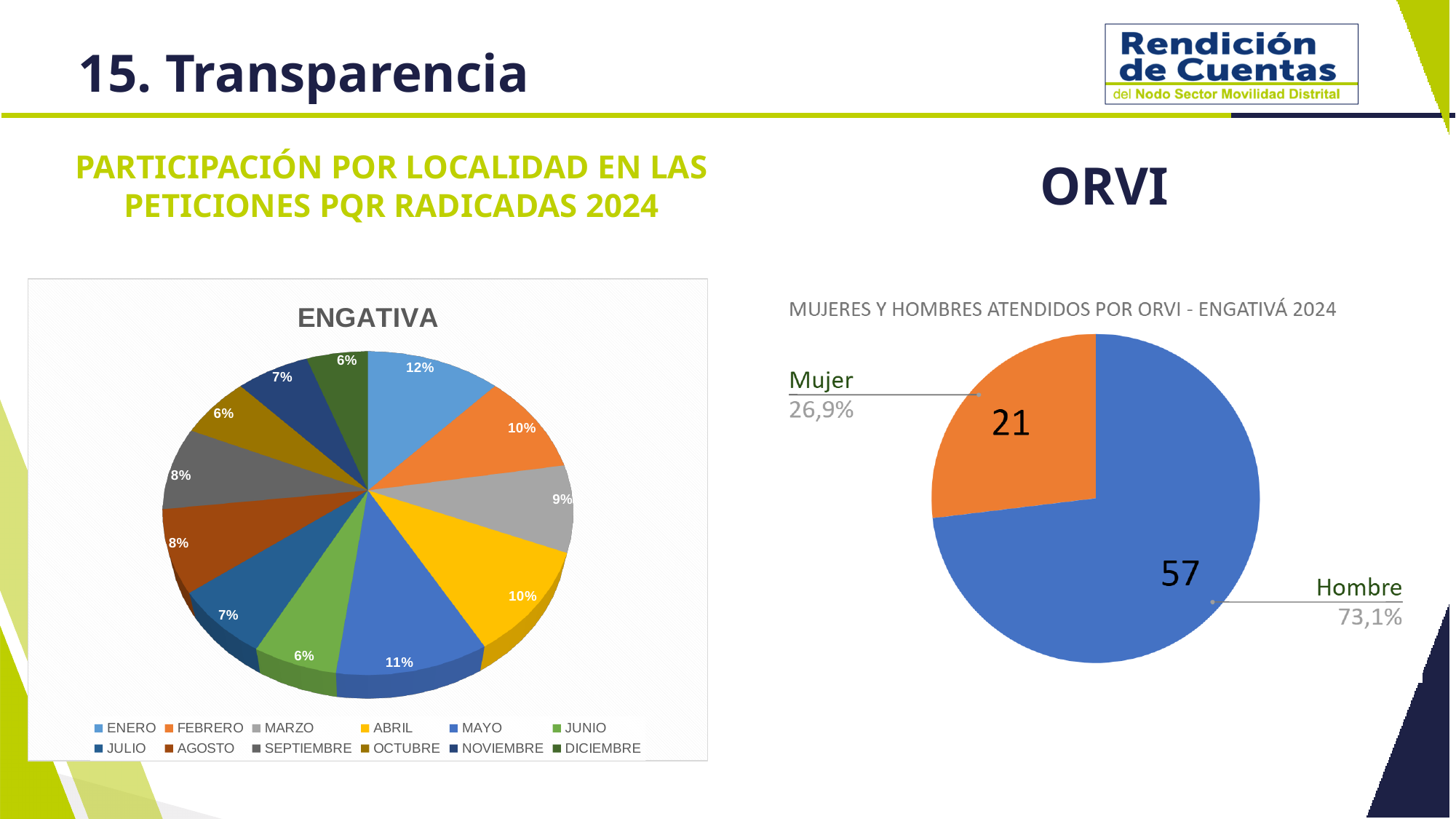
In the chart titled MUJERES Y HOMBRES ATENDIDOS POR ORVI - ENGATIVÁ 2024, how many Mujeres were attended? 21 In the ENGATIVA pie chart, what percentage is shown for MARZO? 9% In the chart titled MUJERES Y HOMBRES ATENDIDOS POR ORVI - ENGATIVÁ 2024, what share of the pie does Mujer represent? 26,9% In the ENGATIVA pie chart, which is larger, the share for FEBRERO or the share for JUNIO? FEBRERO In the ENGATIVA pie chart, how many months (slices) are shown? 12 What kind of chart is the ENGATIVA chart? Pie chart In the chart titled MUJERES Y HOMBRES ATENDIDOS POR ORVI - ENGATIVÁ 2024, how many Hombres were attended? 57 In the chart titled MUJERES Y HOMBRES ATENDIDOS POR ORVI - ENGATIVÁ 2024, what is the difference between the Hombre and Mujer counts? 36 In the ENGATIVA pie chart, what percentage is shown for ENERO? 12% In the ENGATIVA pie chart, which month has the largest share? ENERO In the ENGATIVA pie chart, what percentage is shown for MAYO? 11% In the chart titled MUJERES Y HOMBRES ATENDIDOS POR ORVI - ENGATIVÁ 2024, what is the total number of people attended? 78